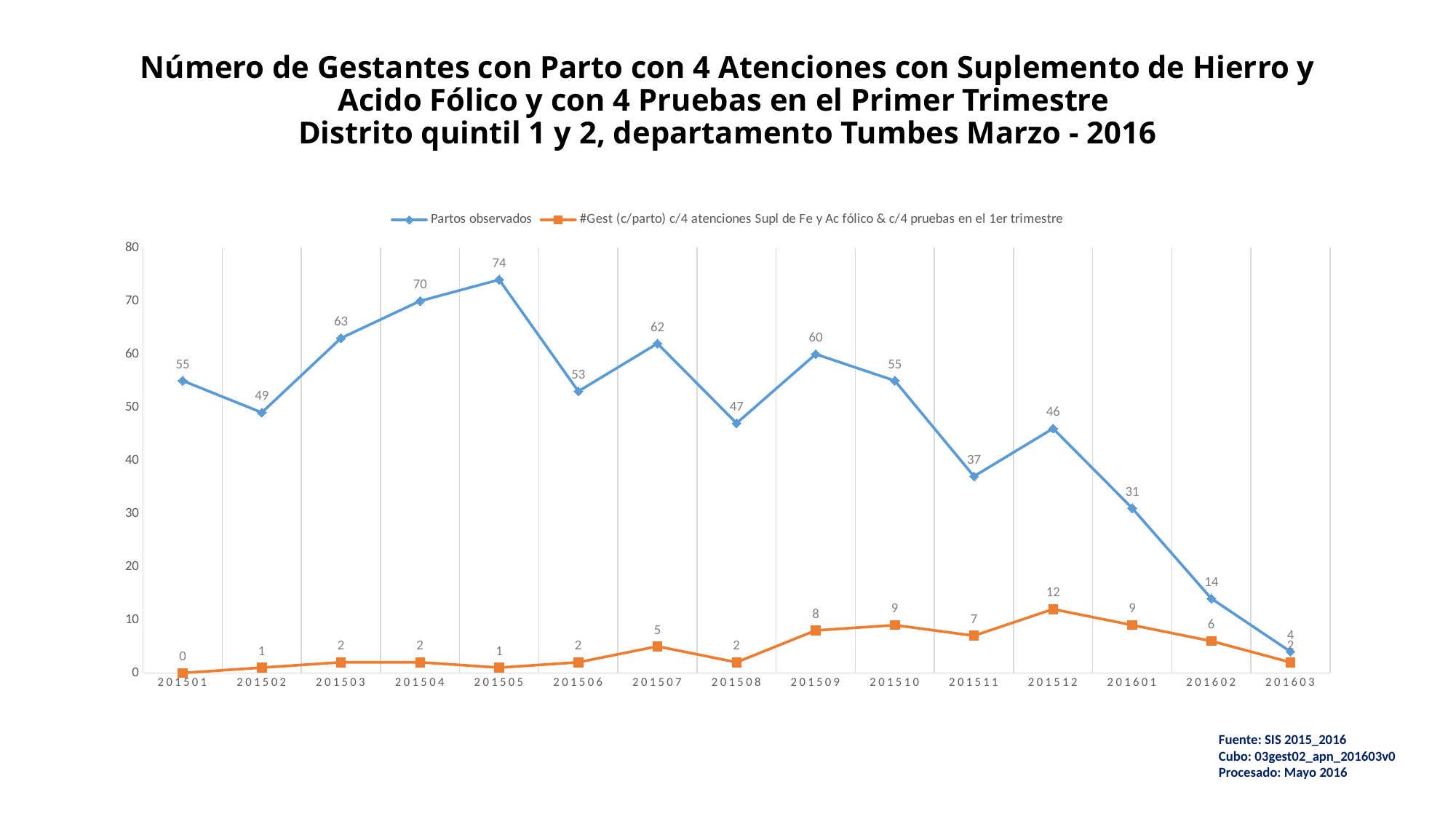
In which period is Partos observados lowest? 201603 What is the value of the #Gest (c/parto) c/4 atenciones series for 201501? 0 What is the value of the #Gest (c/parto) c/4 atenciones series for 201512? 12 What kind of chart is shown? Line chart How many series does the legend list? 2 Which is larger, Partos observados in 201509 or in 201510? 201509 Does Partos observados rise or fall from 201512 to 201603? Fall How many periods are shown on the x axis? 15 In which period is Partos observados highest? 201505 What is the value of Partos observados for 201505? 74 What is the difference between Partos observados in 201501 and 201502? 6 What is the value of Partos observados for 201603? 4